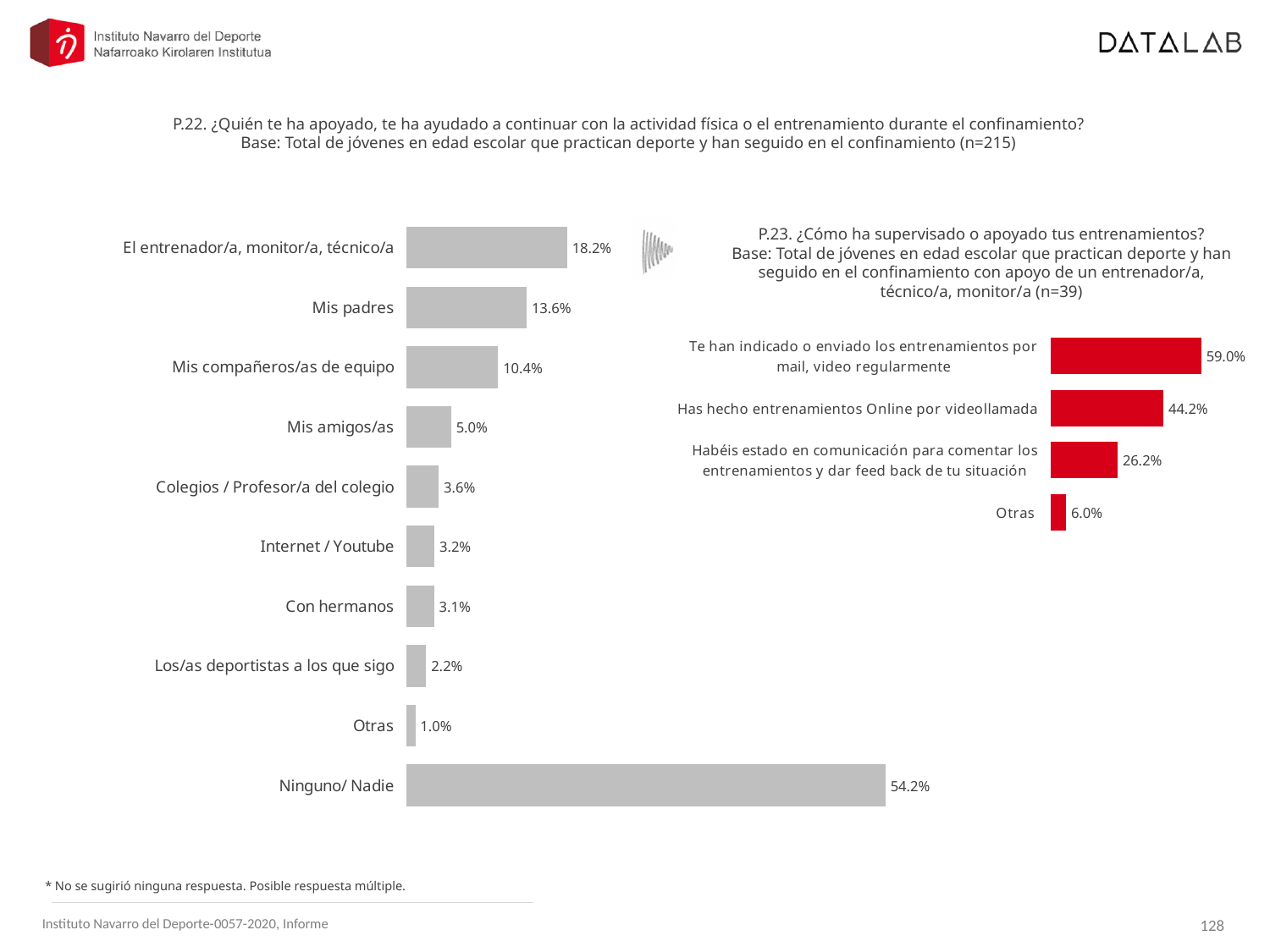
In the P.22 chart on the left, which category has the lowest value? Otras In the P.22 chart on the left, which category has the highest value? Ninguno/ Nadie In the P.22 chart on the left, which is larger: "Mis amigos/as" or "Colegios / Profesor/a del colegio"? Mis amigos/as In the P.22 chart on the left, what is the value for "Mis padres"? 13.6% How many categories are shown in the P.23 chart on the right? 4 In the P.22 chart on the left, what is the value for "Ninguno/ Nadie"? 54.2% What type of chart is the P.23 chart on the right? Bar chart In the P.23 chart on the right, what is the difference between the highest value and "Otras"? 53.0% In the P.23 chart on the right, which category has the highest value? Te han indicado o enviado los entrenamientos por mail, video regularmente How many categories are shown in the P.22 chart on the left? 10 In the P.23 chart on the right, what is the value for "Has hecho entrenamientos Online por videollamada"? 44.2% In the P.22 chart on the left, what is the difference between "El entrenador/a, monitor/a, técnico/a" and "Mis padres"? 4.6%